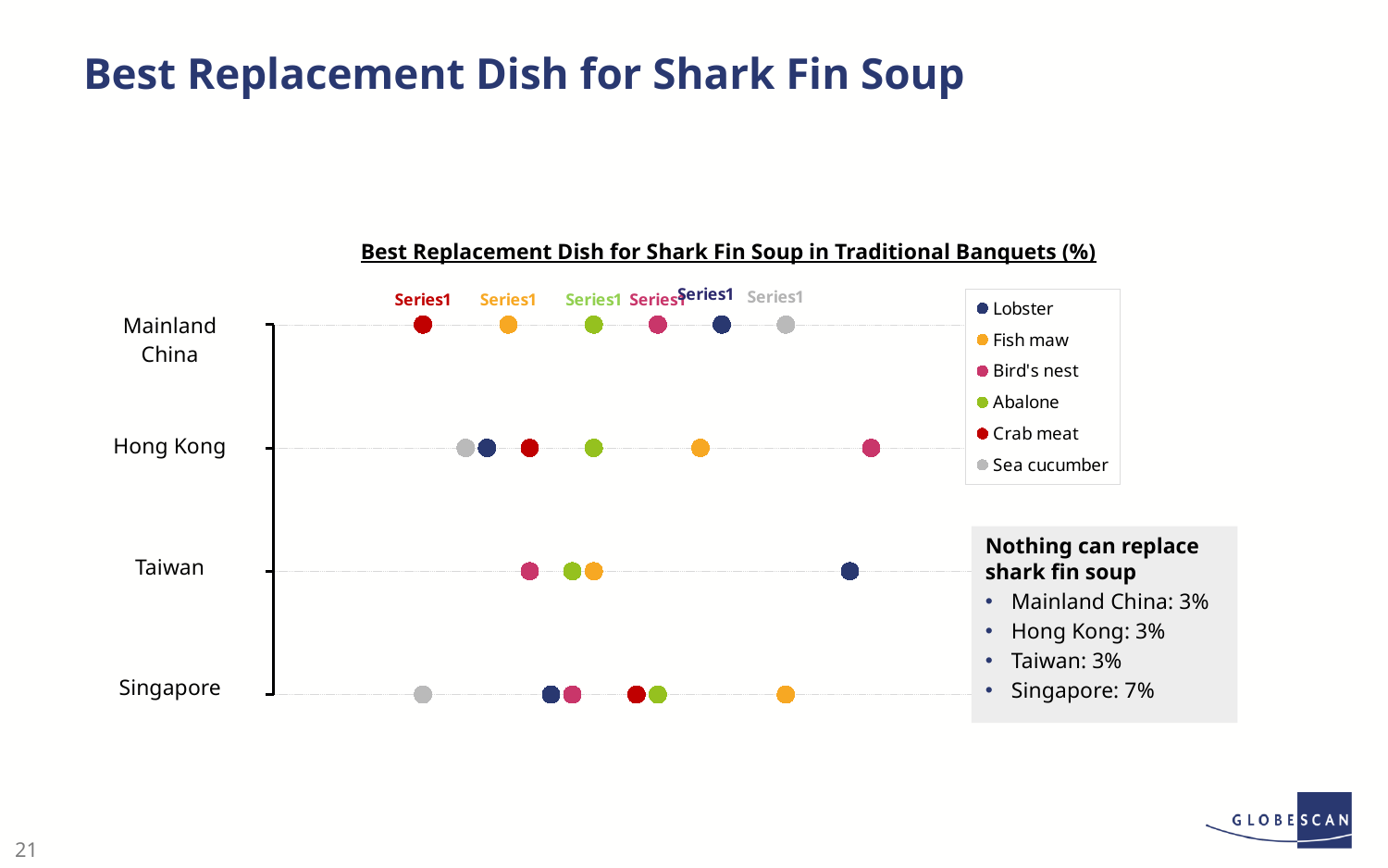
For Hong Kong, which dish has the highest value? Bird's nest For Mainland China, which dish has the lowest value? Crab meat What is the title of the chart? Best Replacement Dish for Shark Fin Soup in Traditional Banquets (%) How many regions (categories) are plotted on the vertical axis? 4 What kind of chart is shown on the slide? scatter (dot) chart How many series does the legend list? 6 For Taiwan, which dish has the highest value? Lobster For Hong Kong, which is larger: the value for Fish maw or the value for Abalone? Fish maw For Singapore, which dish has the lowest value? Sea cucumber For Hong Kong, which dish has the lowest value? Sea cucumber For Singapore, which dish has the highest value? Fish maw